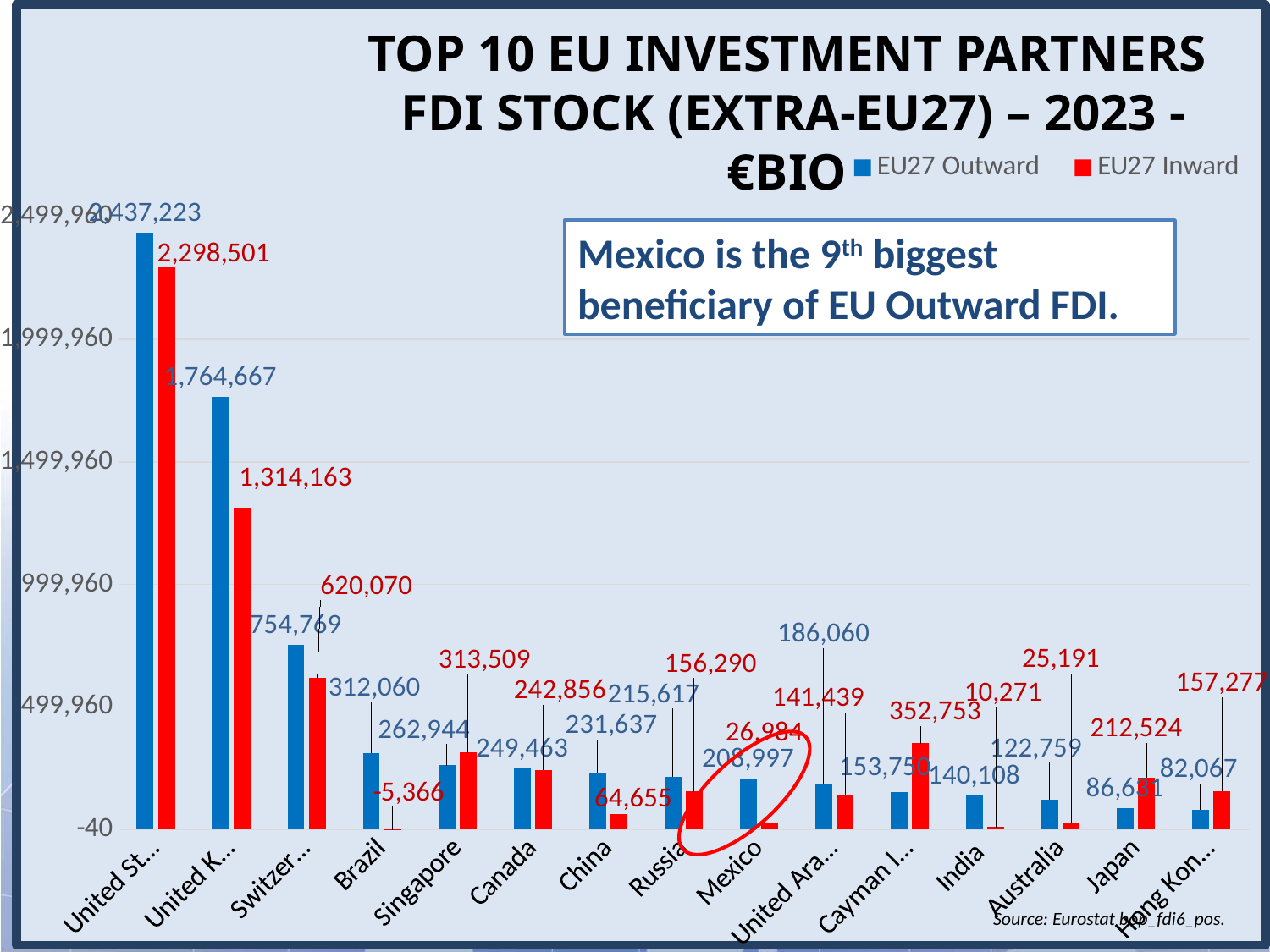
What kind of chart is shown on the slide? bar chart For Singapore, which series is larger, EU27 Outward or EU27 Inward? EU27 Inward How many categories are shown on the x axis? 15 Is the EU27 Outward value for Russia greater or less than 499,960? less What is the EU27 Outward value for China? 231,637 What is the EU27 Inward value for Brazil? -5,366 What is the difference between the EU27 Outward and EU27 Inward values for Canada? 6,607 What is the EU27 Outward value for Mexico? 208,997 How many series does the legend list? 2 What is the EU27 Inward value for Japan? 212,524 Which category has the lowest EU27 Inward value? Brazil What is the difference between the EU27 Outward and EU27 Inward values for Mexico? 182,013